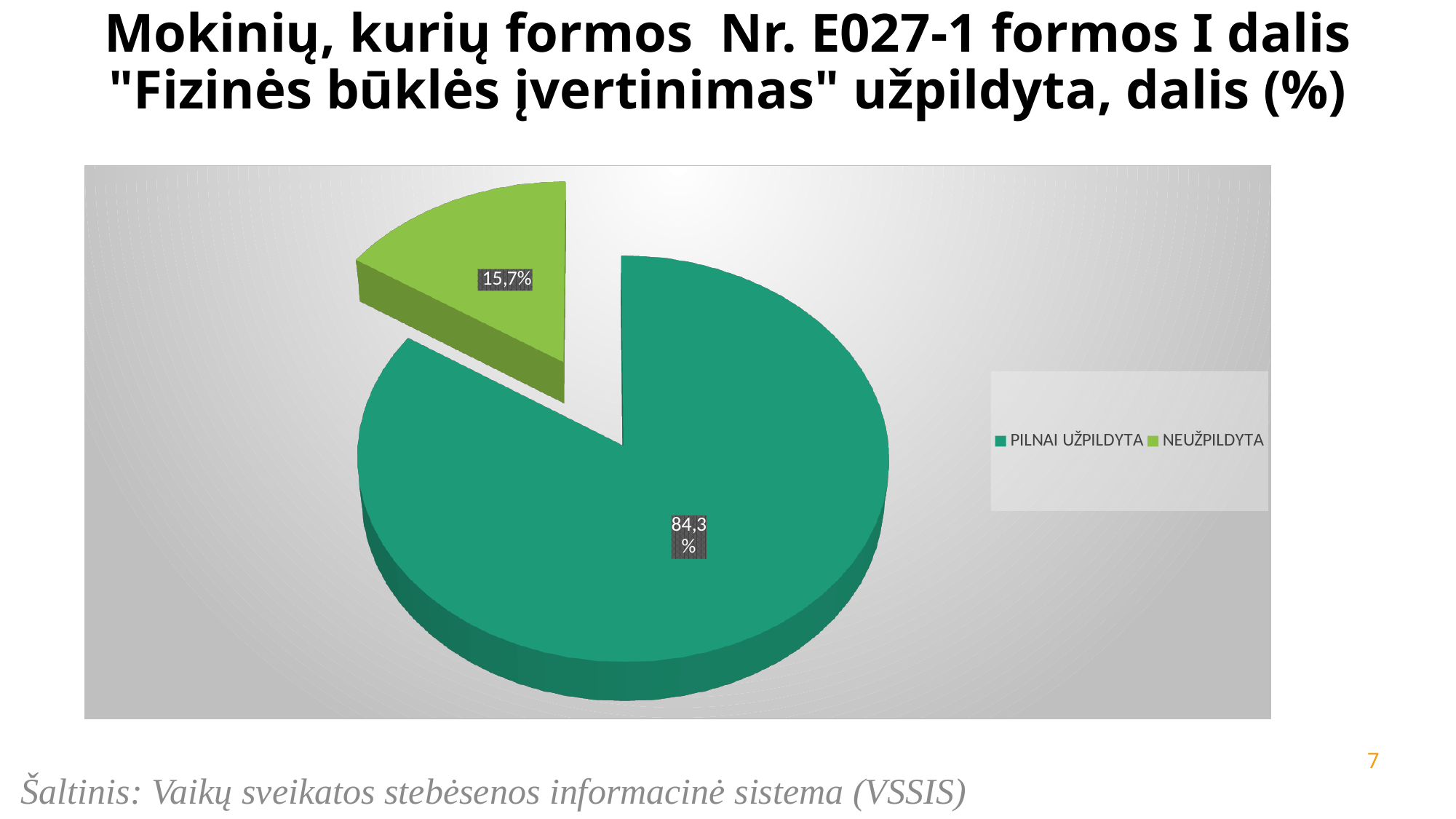
What is the difference in percentage points between the PILNAI UŽPILDYTA and NEUŽPILDYTA slices? 68,6 Which slice of the pie is the smallest? NEUŽPILDYTA What kind of chart is shown on the slide? pie chart How many entries does the legend list? 2 Which slice of the pie is the largest? PILNAI UŽPILDYTA What share of the pie is labelled PILNAI UŽPILDYTA? 84,3% What colour is the NEUŽPILDYTA slice? light green What share of the pie is labelled NEUŽPILDYTA? 15,7% Which is larger, the PILNAI UŽPILDYTA slice or the NEUŽPILDYTA slice? PILNAI UŽPILDYTA Which slice is pulled out (exploded) from the pie? NEUŽPILDYTA How many slices does the pie chart have? 2